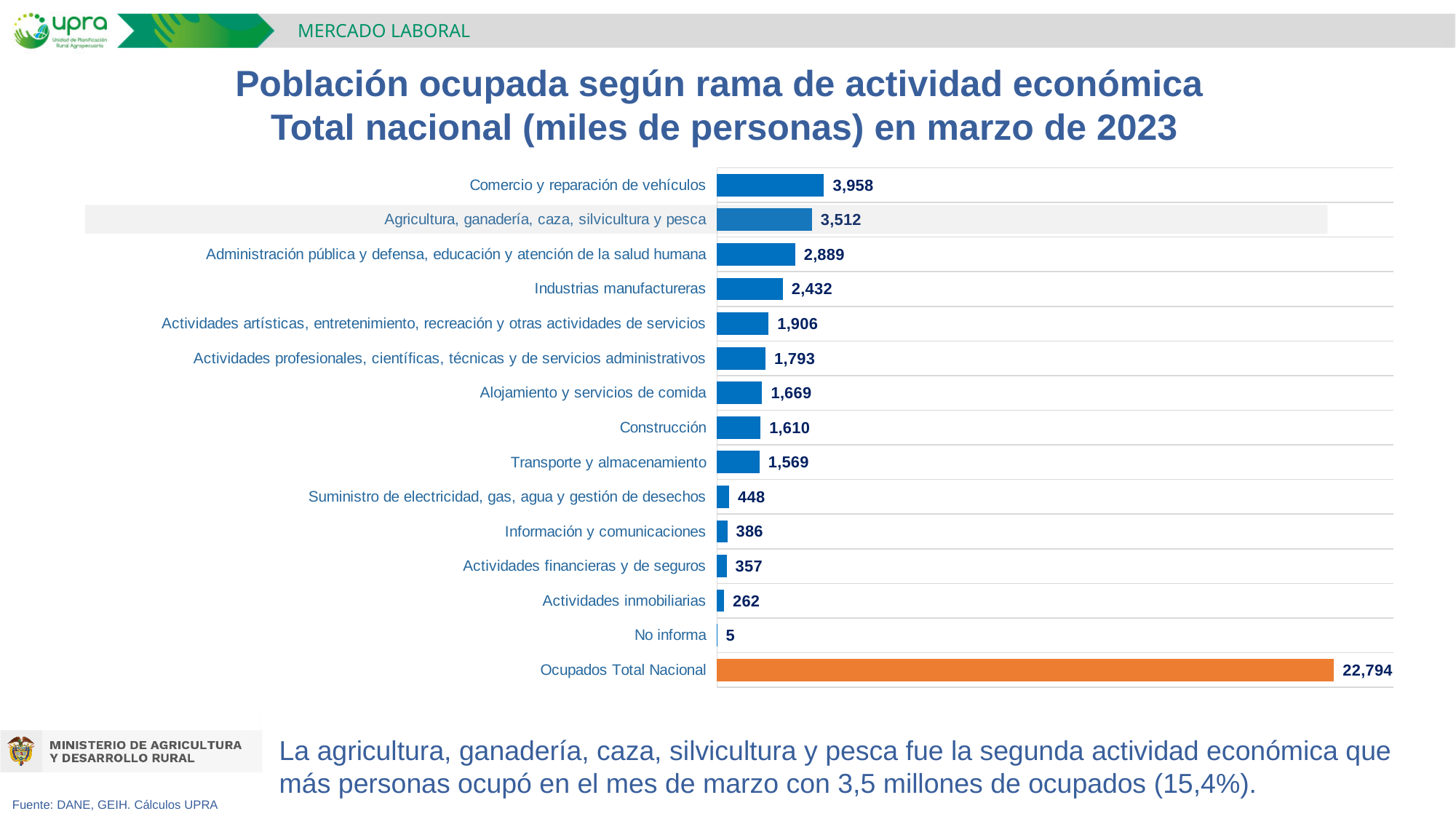
Which bar is coloured orange instead of blue? Ocupados Total Nacional What is the value for Ocupados Total Nacional? 22,794 Excluding the Ocupados Total Nacional bar, which category has the highest value? Comercio y reparación de vehículos What is the difference between Comercio y reparación de vehículos and Agricultura, ganadería, caza, silvicultura y pesca? 446 What is the value for No informa? 5 Which category has the lowest value? No informa How many bars are shown in the chart? 15 What is the difference between Suministro de electricidad, gas, agua y gestión de desechos and Información y comunicaciones? 62 What is the value for Industrias manufactureras? 2,432 What kind of chart is shown on the slide? Bar chart What is the value for Agricultura, ganadería, caza, silvicultura y pesca? 3,512 Which is larger, Construcción or Transporte y almacenamiento? Construcción